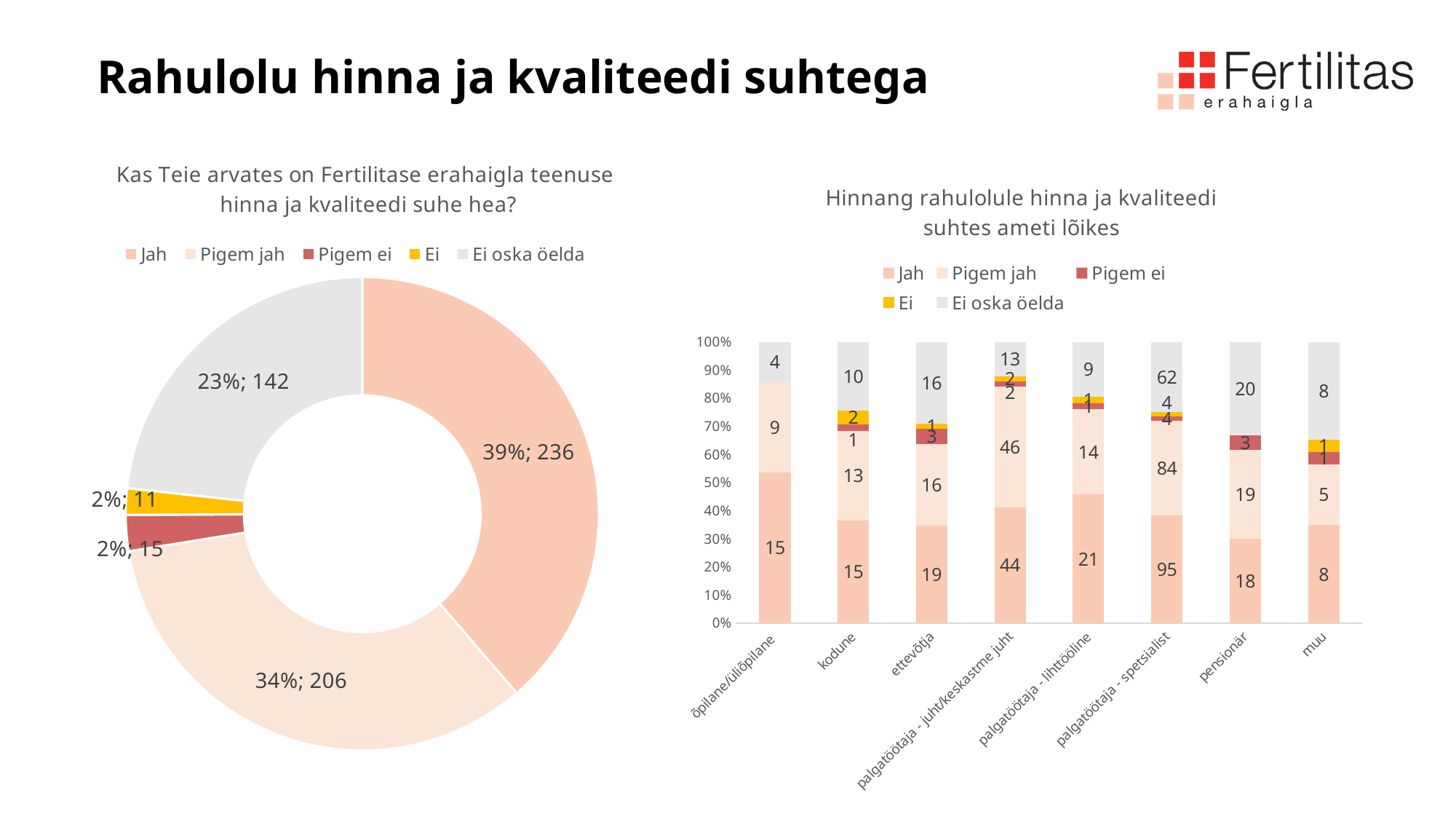
In the left chart, which response category has the largest slice? Jah How many series does the legend of the right chart list? 5 What kind of chart is the left chart? Donut (pie) chart In the left chart, what count is shown for the "Ei oska öelda" slice? 142 In the right chart ("Hinnang rahulolule hinna ja kvaliteedi suhtes ameti lõikes"), what is the "Jah" value for "palgatöötaja - spetsialist"? 95 In the right chart, which occupation category has the highest "Jah" value? palgatöötaja - spetsialist In the left chart, what is the difference between the counts for "Jah" and "Pigem jah"? 30 In the left chart ("Kas Teie arvates on Fertilitase erahaigla teenuse hinna ja kvaliteedi suhe hea?"), what percentage share does the "Jah" slice have? 39% How many occupation categories are shown on the x axis of the right chart? 8 What kind of chart is the right chart? Stacked bar chart In the right chart, what is the total of all segments in the "kodune" bar? 41 In the right chart, what is the "Ei oska öelda" value for "pensionär"? 20